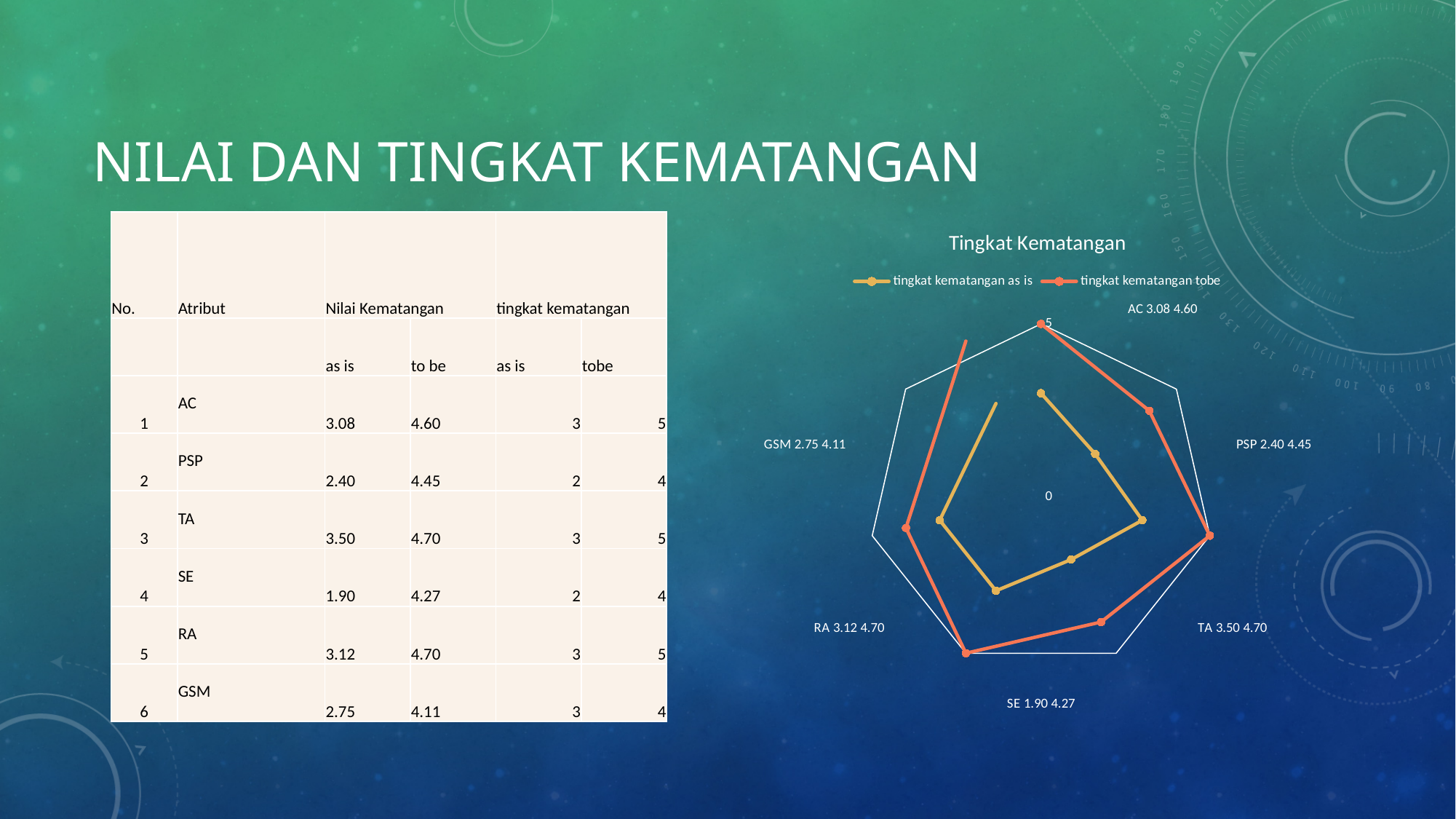
What kind of chart is shown on the slide? radar chart Is the 'tingkat kematangan tobe' value for PSP greater or less than 5? less What are the two series named in the chart's legend? tingkat kematangan as is; tingkat kematangan tobe For AC, which series has the larger value in the chart: 'tingkat kematangan as is' or 'tingkat kematangan tobe'? tingkat kematangan tobe Which has the larger 'tingkat kematangan tobe' value in the chart: PSP or TA? TA Which has the larger 'tingkat kematangan as is' value in the chart: AC or PSP? AC What is the title of the chart on the slide? Tingkat Kematangan What is the value of 'tingkat kematangan tobe' for AC in the chart? 5 How many series does the chart's legend list? 2 Is the 'tingkat kematangan as is' value for SE greater or less than 5? less How many categories (axes) does the radar chart have? 6